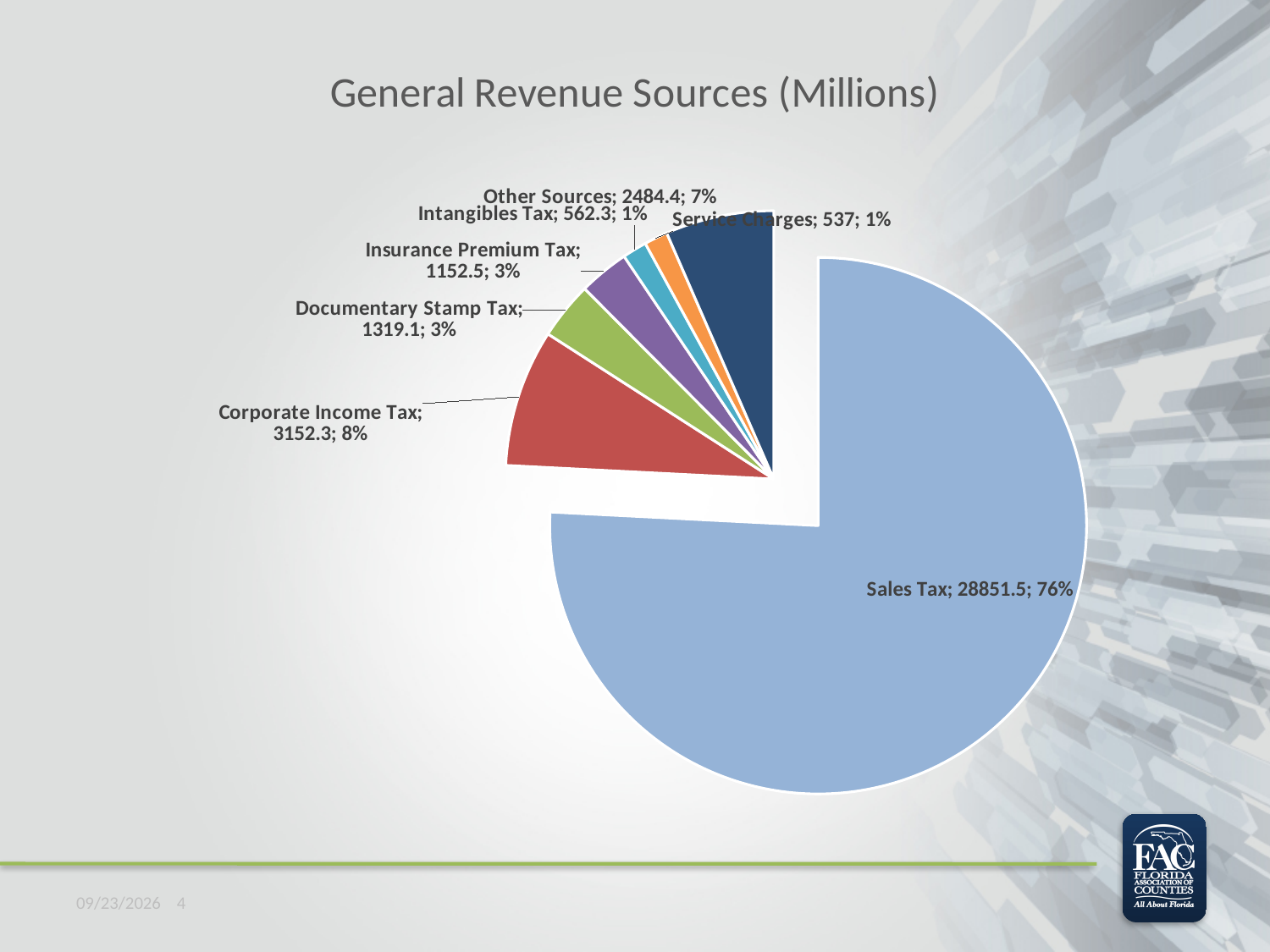
Which category has the smallest slice? Service Charges How many slices does the pie chart have? 7 What is the value for Other Sources? 2484.4 What is the value for Sales Tax? 28851.5 What is the difference between the values for Documentary Stamp Tax and Insurance Premium Tax? 166.6 What share of the pie does Corporate Income Tax represent? 8% What kind of chart is shown on the slide? Pie chart What is the value for Service Charges? 537 Which is larger, Other Sources or Corporate Income Tax? Corporate Income Tax What share of the pie does Sales Tax represent? 76% What is the value for Corporate Income Tax? 3152.3 Which category has the largest slice? Sales Tax